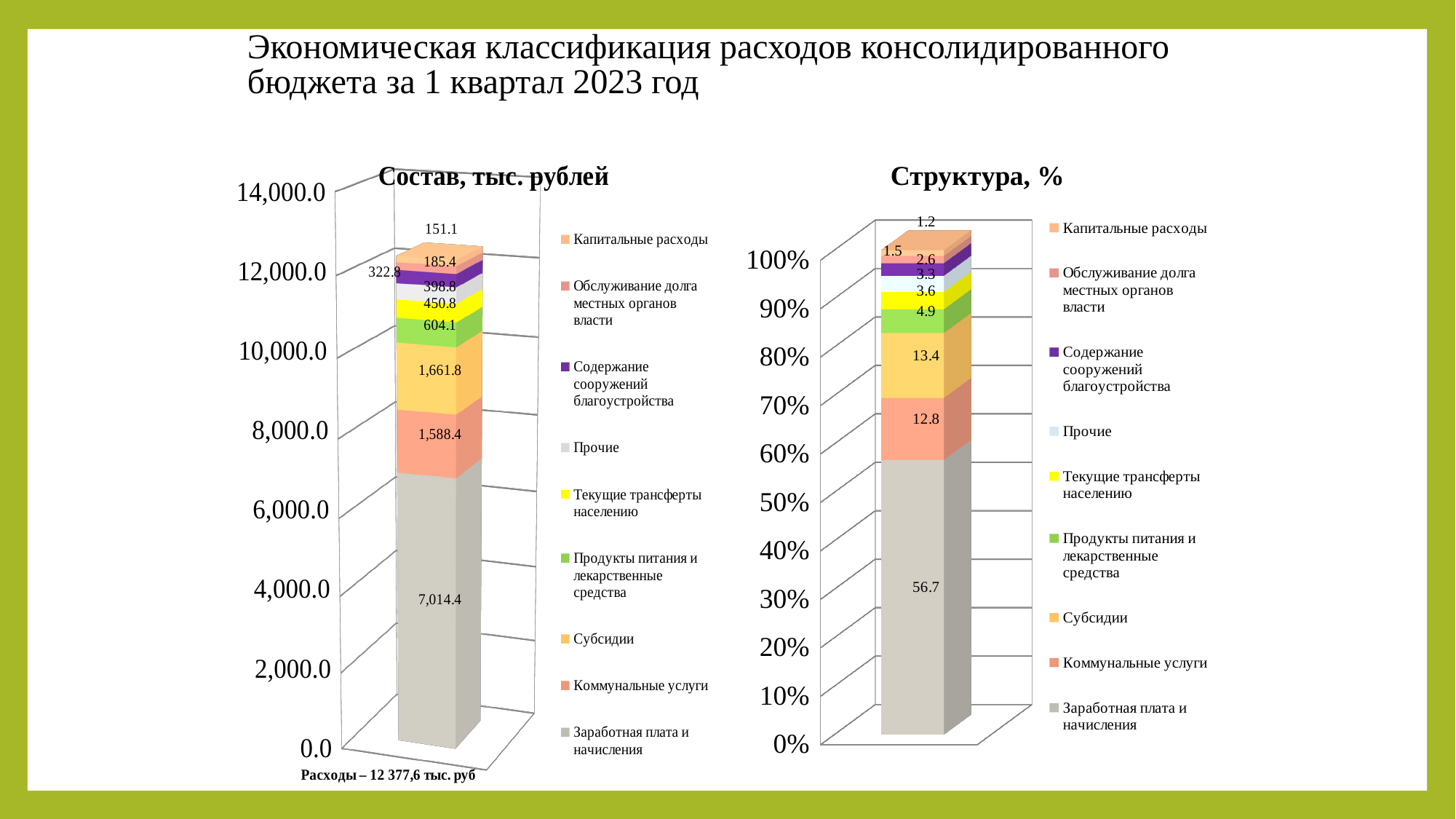
On the chart titled 'Состав, тыс. рублей', which series has the smallest value? Капитальные расходы On the chart titled 'Состав, тыс. рублей', what is the value for 'Субсидии'? 1,661.8 On the chart titled 'Состав, тыс. рублей', what is the total of the stacked bar as stated on the slide? 12 377,6 тыс. руб On the chart titled 'Структура, %', what is the value for 'Коммунальные услуги'? 12.8 On the chart titled 'Структура, %', what is the value for 'Продукты питания и лекарственные средства'? 4.9 On the chart titled 'Состав, тыс. рублей', which series has the largest value? Заработная плата и начисления On the chart titled 'Структура, %', which is larger: 'Текущие трансферты населению' or 'Прочие'? Текущие трансферты населению On the chart titled 'Структура, %', what colour is the segment for 'Содержание сооружений благоустройства'? Purple What kind of chart is the chart titled 'Состав, тыс. рублей'? Stacked bar chart On the chart titled 'Состав, тыс. рублей', what is the difference between 'Субсидии' and 'Коммунальные услуги'? 73.4 On the chart titled 'Состав, тыс. рублей', what is the value for 'Заработная плата и начисления'? 7,014.4 How many series does the legend of the chart titled 'Структура, %' list? 9